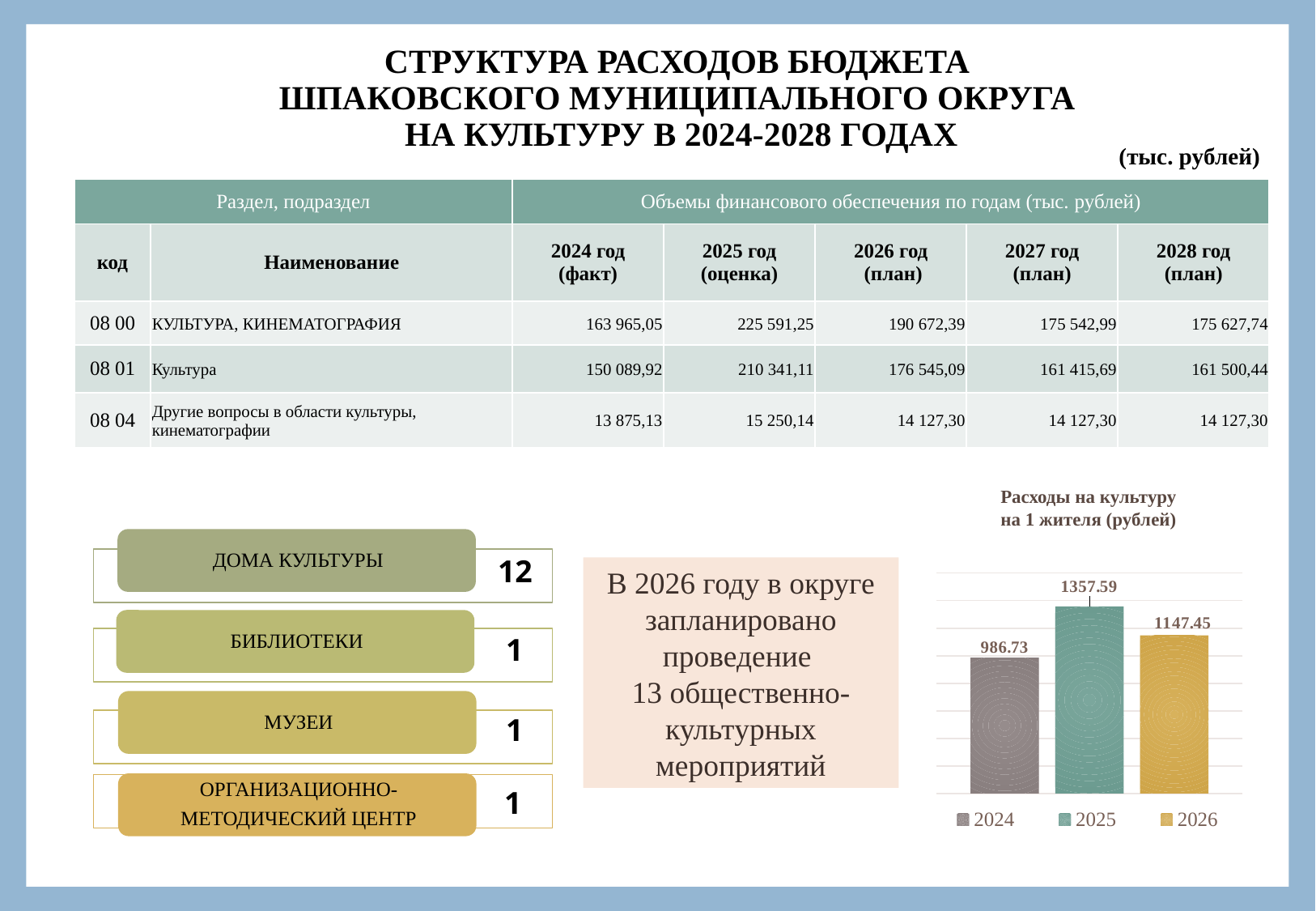
How many entries does the legend of the chart 'Расходы на культуру на 1 жителя (рублей)' list? 3 In the chart 'Расходы на культуру на 1 жителя (рублей)', what is the difference between the 2025 and 2026 values? 210.14 In the chart 'Расходы на культуру на 1 жителя (рублей)', what is the value for 2025? 1357.59 In the chart 'Расходы на культуру на 1 жителя (рублей)', what is the value for 2026? 1147.45 What kind of chart is 'Расходы на культуру на 1 жителя (рублей)'? Bar chart In the chart 'Расходы на культуру на 1 жителя (рублей)', which year has the lowest value? 2024 In the chart 'Расходы на культуру на 1 жителя (рублей)', what is the value for 2024? 986.73 In the chart 'Расходы на культуру на 1 жителя (рублей)', which is larger, the value for 2026 or the value for 2024? 2026 In the chart 'Расходы на культуру на 1 жителя (рублей)', what colour is the bar for 2026? Yellow In the chart 'Расходы на культуру на 1 жителя (рублей)', what is the difference between the 2025 and 2024 values? 370.86 How many bars are shown in the chart 'Расходы на культуру на 1 жителя (рублей)'? 3 In the chart 'Расходы на культуру на 1 жителя (рублей)', which year has the highest value? 2025